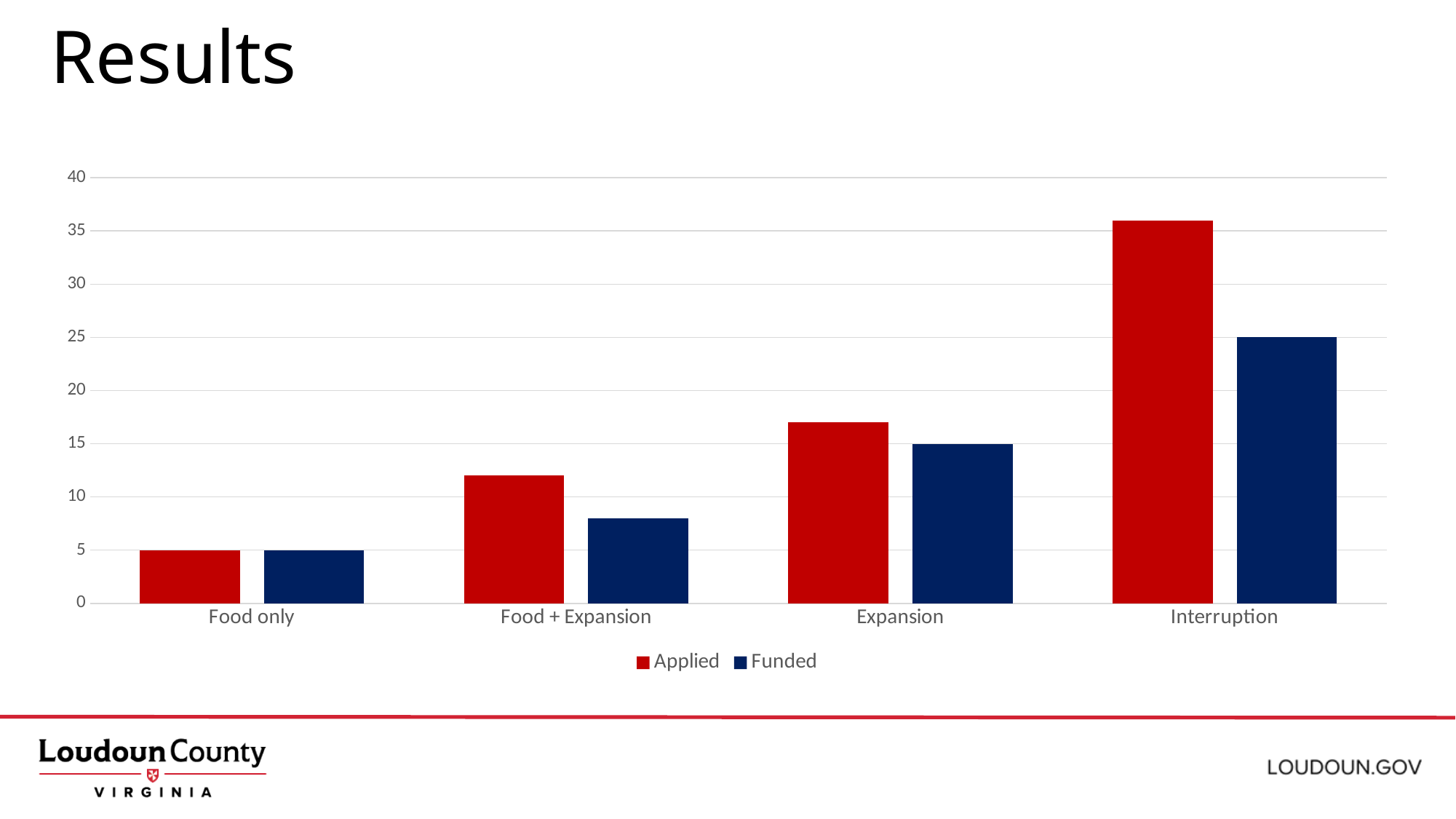
For Interruption, which is larger: Applied or Funded? Applied Is the Funded value for Food + Expansion greater or less than 10? less What is the Funded value for Expansion? 15 What is the difference between the Funded values for Interruption and Expansion? 10 What is the Funded value for Interruption? 25 Which category has the lowest Funded value? Food only Which category has the highest Applied value? Interruption What kind of chart is shown on the slide? Bar chart Is the Applied value for Interruption greater or less than 35? greater How many categories are shown on the x axis? 4 How many series does the legend list? 2 What is the Applied value for Food only? 5